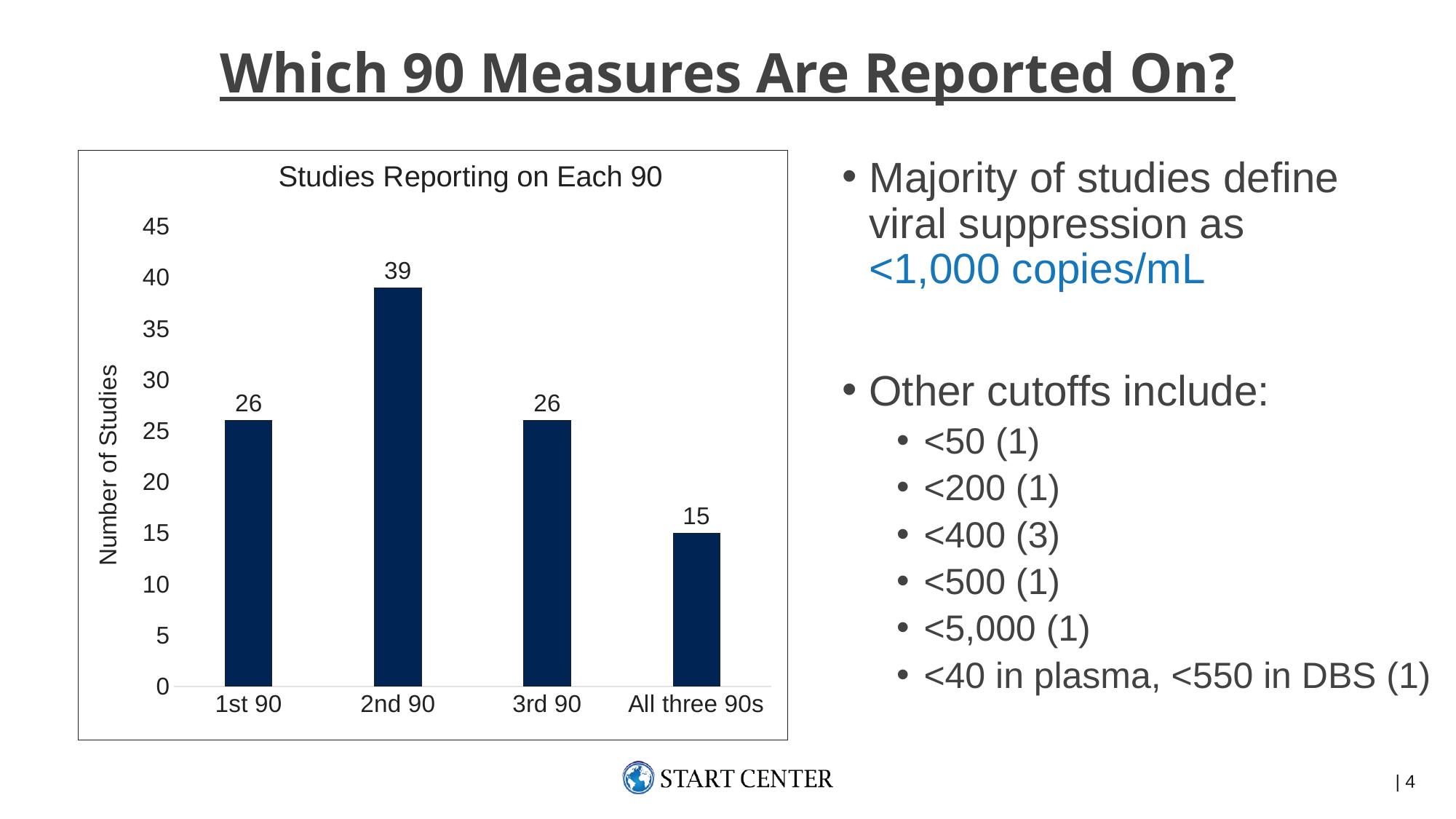
What kind of chart is shown on the slide? Bar chart How many categories are shown on the x axis of the chart? 4 Which has more studies, the 2nd 90 or all three 90s? 2nd 90 How many studies report on all three 90s? 15 Which category has the highest number of studies? 2nd 90 Which category has the lowest number of studies? All three 90s What is the title of the chart? Studies Reporting on Each 90 How many studies report on the 2nd 90? 39 What is the difference between the number of studies reporting on the 2nd 90 and the 3rd 90? 13 How many studies report on the 1st 90? 26 What is the difference between the number of studies reporting on the 1st 90 and all three 90s? 11 What is the label of the y axis of the chart? Number of Studies